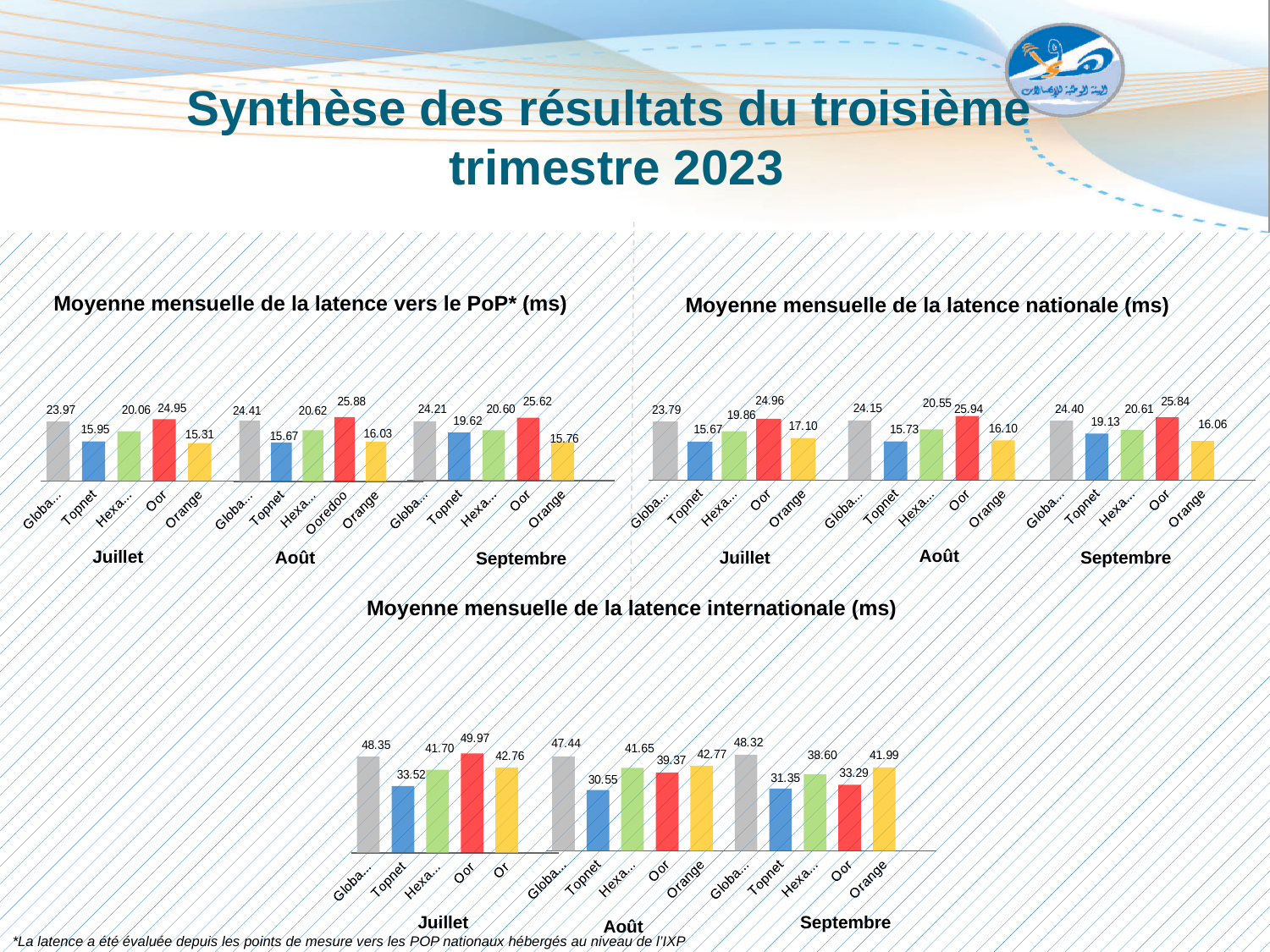
In the chart 'Moyenne mensuelle de la latence internationale (ms)', is the Orange value larger in Juillet or in Septembre? Juillet In the chart 'Moyenne mensuelle de la latence nationale (ms)', what is the value for Orange in Septembre? 16.06 In the chart 'Moyenne mensuelle de la latence vers le PoP* (ms)', what is the difference between Topnet and Orange in Juillet? 0.64 In the chart 'Moyenne mensuelle de la latence nationale (ms)', does the Orange value rise or fall from Juillet to Septembre? fall In the chart 'Moyenne mensuelle de la latence vers le PoP* (ms)', what is the value for Topnet in Juillet? 15.95 In the chart 'Moyenne mensuelle de la latence internationale (ms)', which operator has the lowest value in Juillet? Topnet In the chart 'Moyenne mensuelle de la latence vers le PoP* (ms)', is the Topnet value larger in Juillet or in Septembre? Septembre In the chart 'Moyenne mensuelle de la latence vers le PoP* (ms)', which operator has the highest value in Août? Ooredoo How many months are shown in the chart 'Moyenne mensuelle de la latence nationale (ms)'? 3 What kind of chart is 'Moyenne mensuelle de la latence internationale (ms)'? bar chart In the chart 'Moyenne mensuelle de la latence internationale (ms)', what is the difference between Topnet in Septembre and Topnet in Août? 0.80 In the chart 'Moyenne mensuelle de la latence internationale (ms)', what is the value for Topnet in Août? 30.55